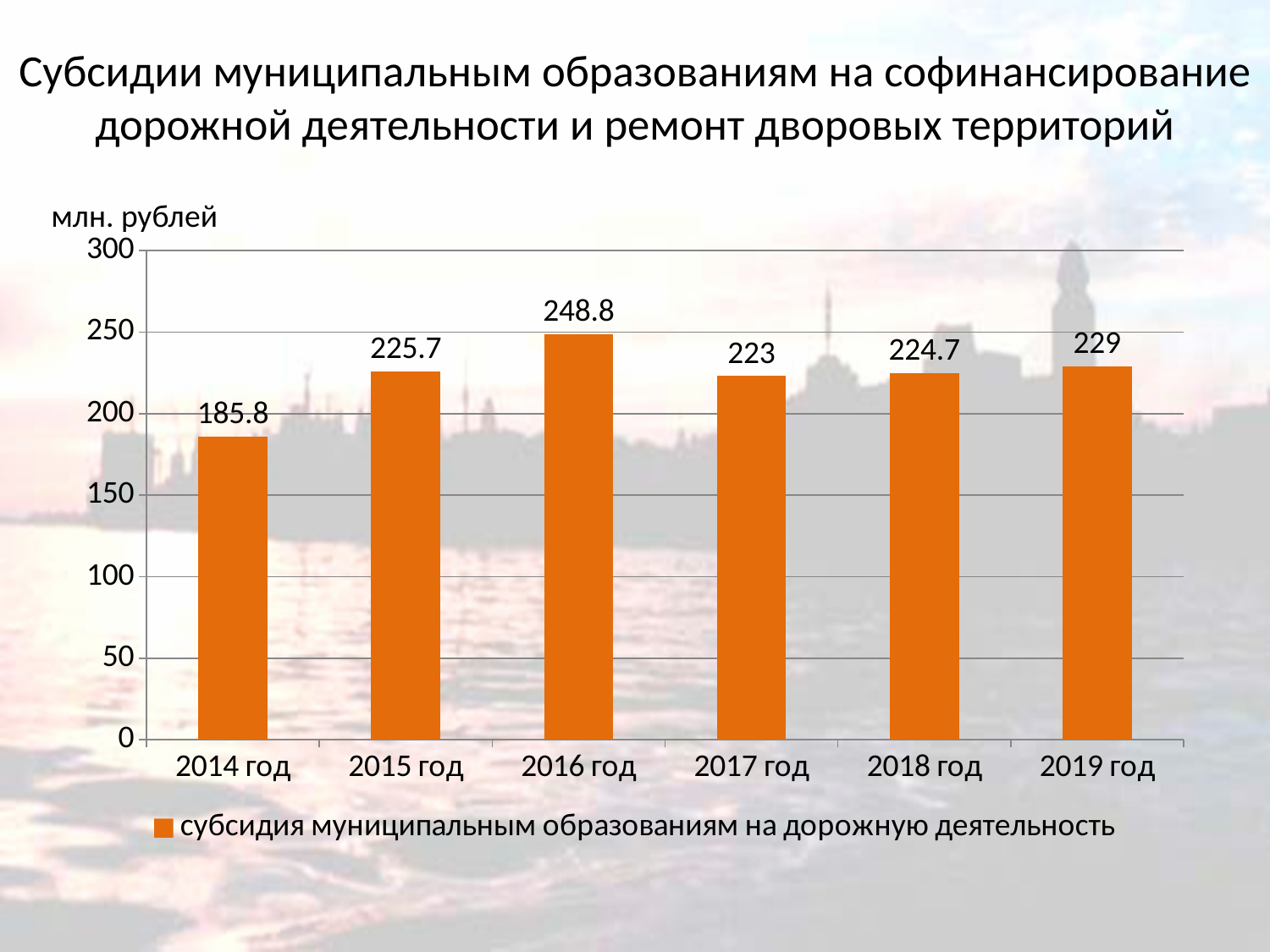
What is the value for 2018 год? 224.7 What unit is shown above the vertical axis? млн. рублей What is the difference between the values for 2019 год and 2017 год? 6 What kind of chart is shown on the slide? bar chart What is the value for 2014 год? 185.8 Which is larger, the value for 2015 год or the value for 2019 год? 2019 год How many years are shown on the x axis? 6 Is the value for 2014 год greater or less than 200? less Which year has the lowest value? 2014 год What is the difference between the values for 2016 год and 2014 год? 63 What is the value for 2016 год? 248.8 Which year has the highest value? 2016 год